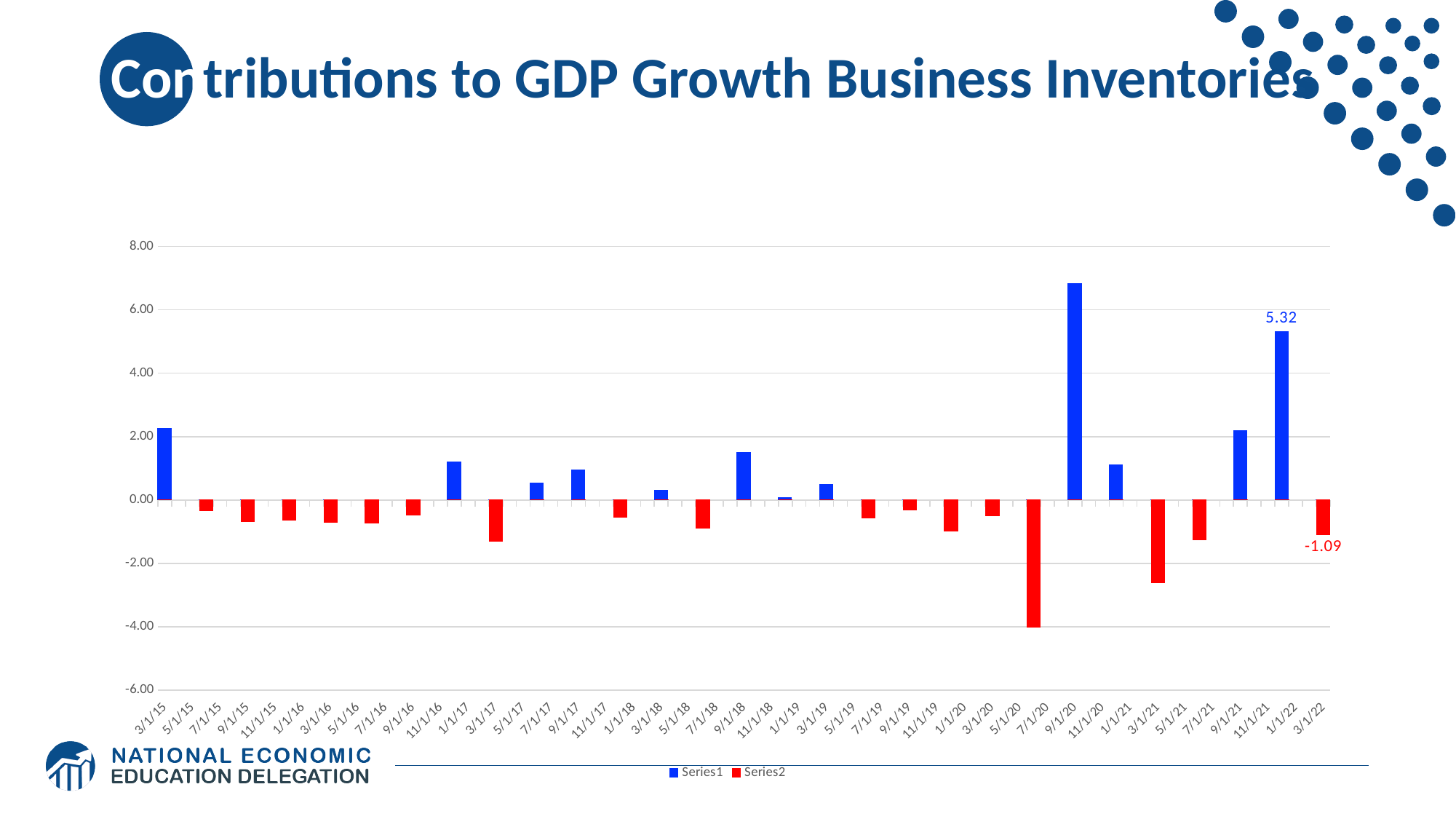
What colour represents Series2 in the legend? Red What kind of chart is shown on the slide? Bar chart What value is labeled on the red bar at 3/1/22? -1.09 What value is labeled on the blue bar at 1/1/22? 5.32 What is the difference between the labeled values at 1/1/22 (5.32) and 3/1/22 (-1.09)? 6.41 Is the tallest bar on the chart greater or less than 6.00? greater Which series contains the tallest bar on the chart? Series1 What is the title of the chart? Contributions to GDP Growth Business Inventories What is the highest value shown on the vertical axis? 8.00 Which is larger, the labeled value at 1/1/22 or the labeled value at 3/1/22? 1/1/22 (5.32) How many series does the legend list? 2 Is the lowest red bar on the chart greater or less than -2.00? less